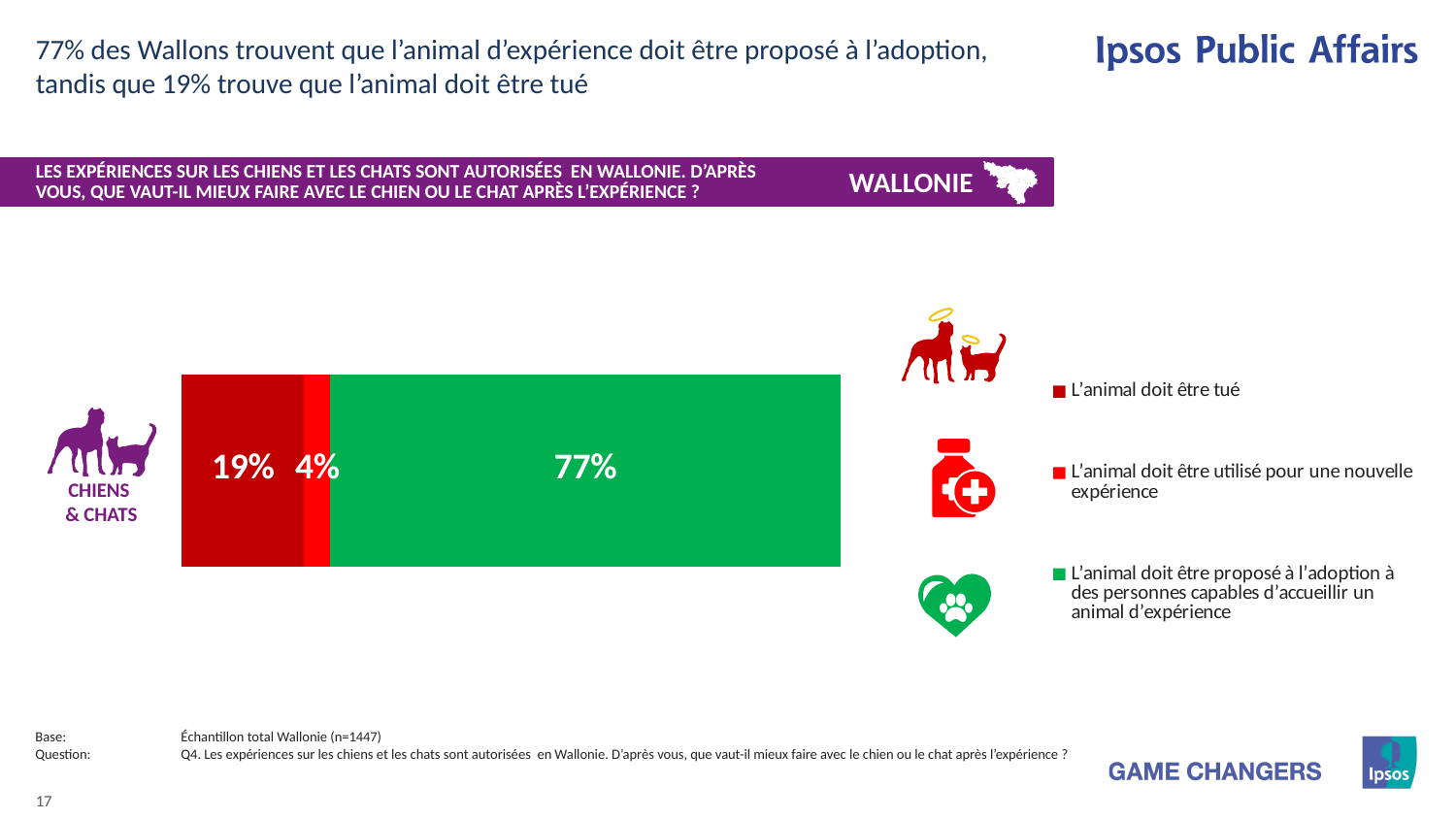
How many series does the legend list? 3 What kind of chart is shown on the slide? Stacked bar chart What is the total of the three segments in the stacked bar? 100% What is the difference in percentage points between 'L'animal doit être tué' and 'L'animal doit être utilisé pour une nouvelle expérience'? 15 What is the difference in percentage points between the adoption response and the 'animal doit être tué' response? 58 Which response has the lowest share in the bar? L'animal doit être utilisé pour une nouvelle expérience Which response has the highest share in the bar? L'animal doit être proposé à l'adoption à des personnes capables d'accueillir un animal d'expérience What percentage of respondents say the animal should be used for a new experiment (L'animal doit être utilisé pour une nouvelle expérience)? 4% What colour is the segment for 'L'animal doit être proposé à l'adoption'? Green What percentage of respondents say the animal should be killed (L'animal doit être tué)? 19% What percentage of respondents say the animal should be offered for adoption (L'animal doit être proposé à l'adoption)? 77% Which is larger: the share for 'L'animal doit être tué' or the share for 'L'animal doit être utilisé pour une nouvelle expérience'? L'animal doit être tué